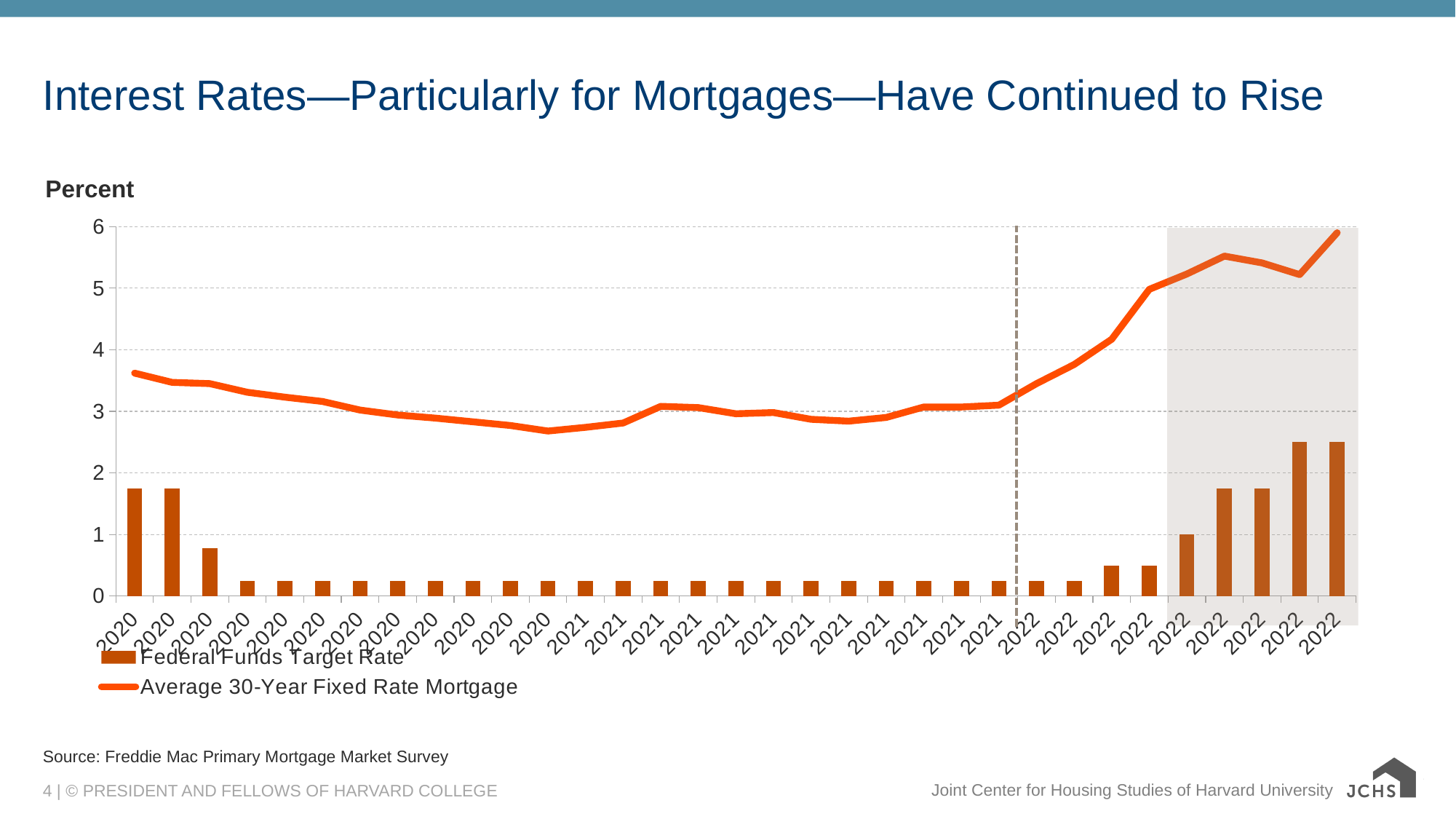
Is the value of the Average 30-Year Fixed Rate Mortgage at the last point in 2022 greater or less than 5? greater Is the Federal Funds Target Rate bar at the last point in 2022 greater or less than 2? greater Which series is drawn as bars? Federal Funds Target Rate Which is larger: the Federal Funds Target Rate bar at the last 2022 point or at the first 2020 point? The last 2022 point How many series does the legend list? 2 What kind of chart is shown on the slide? A combined bar and line chart Is the Federal Funds Target Rate bar at the first point in 2020 greater or less than 2? less Does the Average 30-Year Fixed Rate Mortgage rise or fall across the 2022 points? Rise In which year does the Average 30-Year Fixed Rate Mortgage reach its highest value? 2022 What is the label on the vertical axis of the chart? Percent